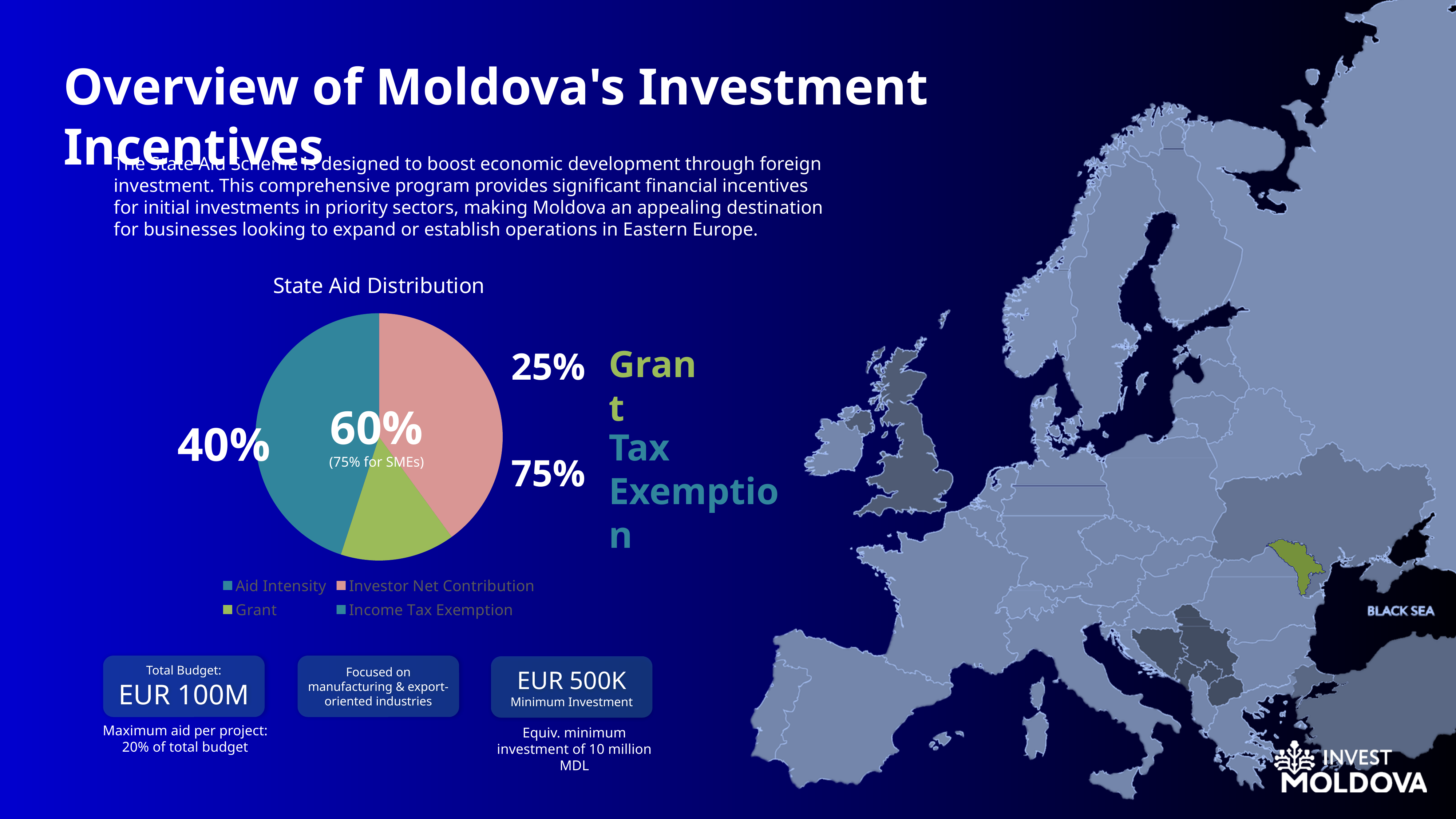
What percentage is printed in the centre of the State Aid Distribution pie chart? 60% How many entries does the legend of the State Aid Distribution chart list? 4 What kind of chart is the State Aid Distribution chart? pie chart In the State Aid Distribution pie chart, which slice is larger: Investor Net Contribution or Income Tax Exemption? Income Tax Exemption Which slice is the largest in the State Aid Distribution pie chart? Income Tax Exemption What is the title of the pie chart on the slide? State Aid Distribution How many slices does the State Aid Distribution pie chart have? 3 Which legend entry of the pie chart is shown in green? Grant